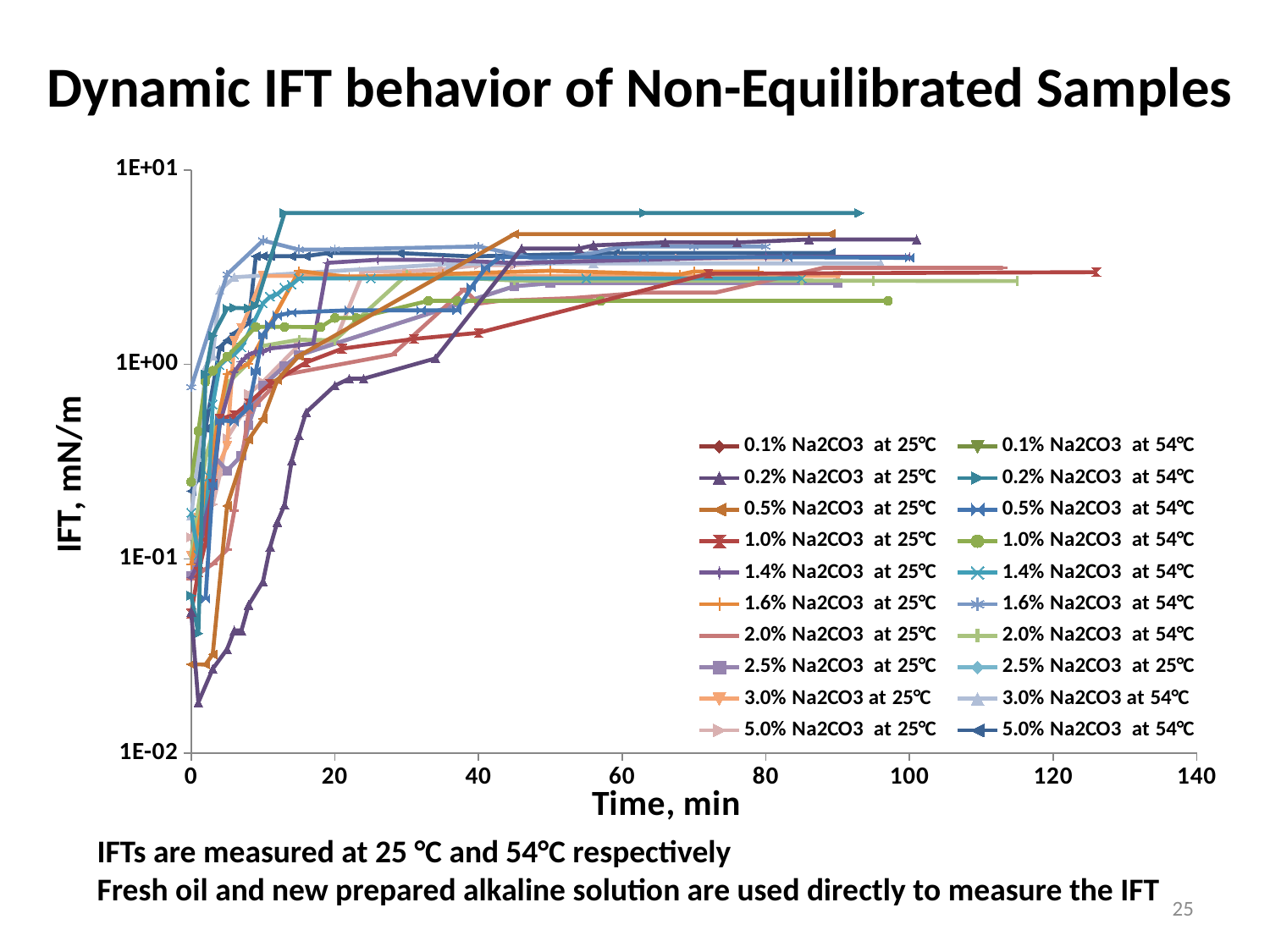
Which series reaches the highest IFT value on the chart? 0.2% Na2CO3 at 54℃ Do the IFT values generally rise or fall as time increases? rise What is the maximum value shown on the x axis? 140 What kind of chart is shown on the slide? line chart What is the label of the y axis? IFT, mN/m How many series does the legend list? 20 Is the initial value of the 0.2% Na2CO3 at 25℃ series greater or less than 1E-01? less Is the final value of the 1.0% Na2CO3 at 54℃ series greater or less than 1E+00? greater Which series has the lowest initial IFT value? 0.5% Na2CO3 at 25℃ How many different Na2CO3 concentrations are listed in the legend? 10 Is the plateau value of the 0.2% Na2CO3 at 54℃ series greater or less than 1E+00? greater What is the title of the chart? Dynamic IFT behavior of Non-Equilibrated Samples